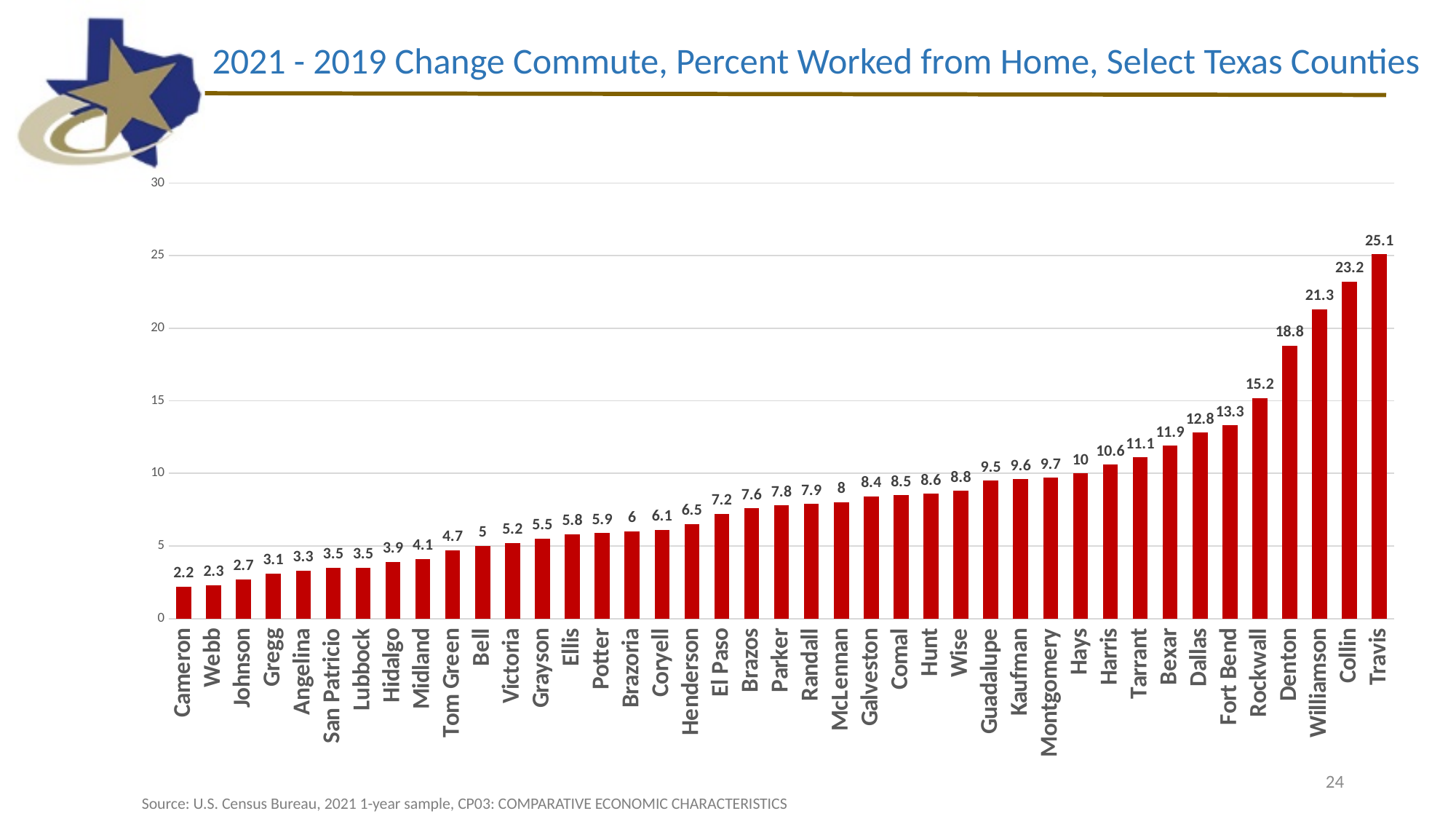
Which county has the highest value? Travis What is the value for El Paso? 7.2 What is the title of the chart? 2021 - 2019 Change Commute, Percent Worked from Home, Select Texas Counties Is the value for Rockwall greater or less than 15? greater Do the values rise or fall from left to right along the x axis? rise How many counties are shown on the chart? 41 What is the difference between the values for Collin and Denton? 4.4 Which is larger, the value for Dallas or the value for Bexar? Dallas What kind of chart is this? bar chart What is the value for Travis? 25.1 Which county has the lowest value? Cameron What is the value for Harris? 10.6